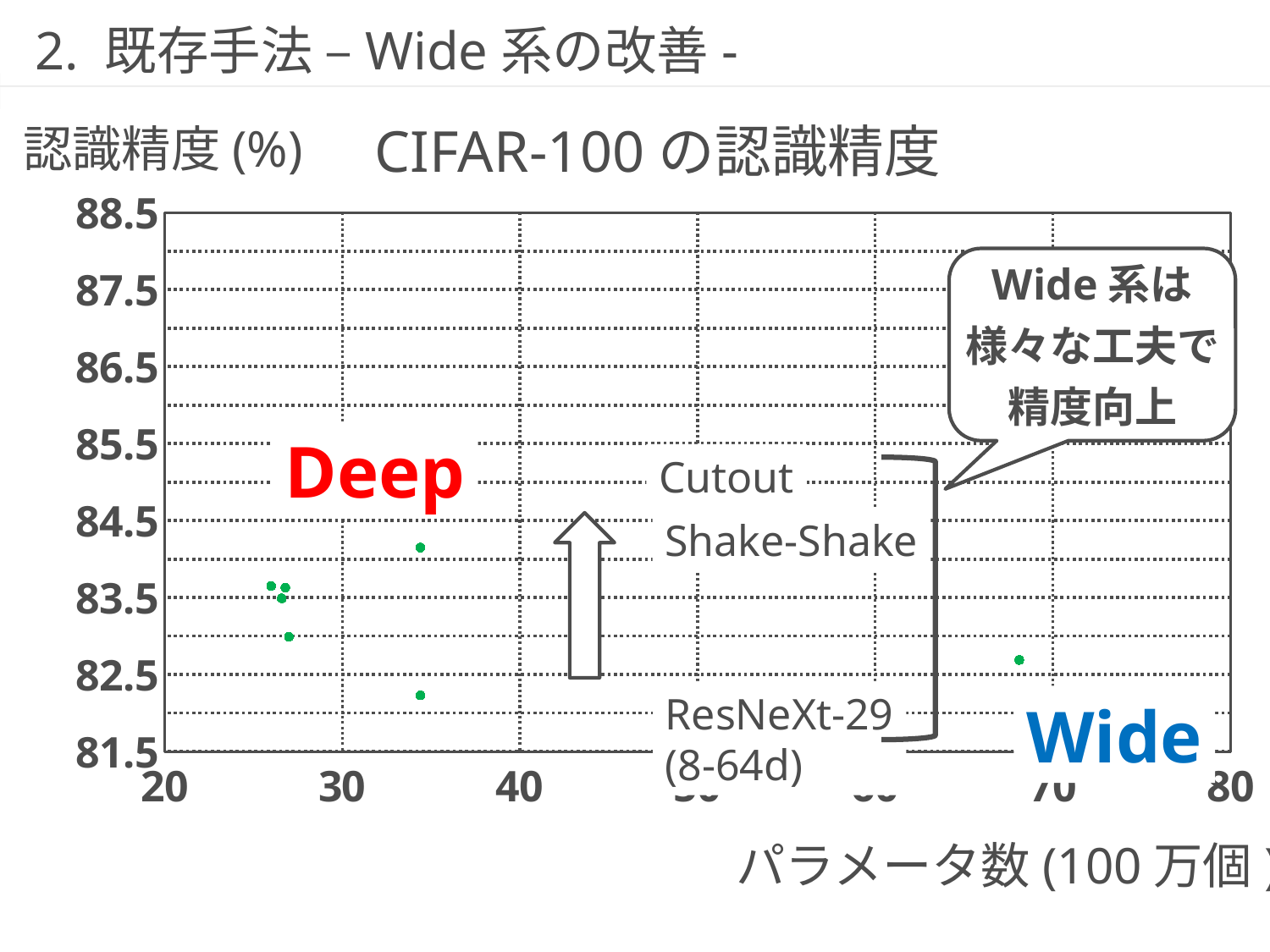
What kind of chart is shown on the slide? scatter chart Which is larger: the value of the point near 68 on the x axis or the value of the highest point near 35 on the x axis? the point near 35 on the x axis Is the value of the highest plotted point greater or less than 83.5? greater Which is larger: the value of the point near 68 on the x axis or the value of the lowest point near 35 on the x axis? the point near 68 on the x axis What is the title of the chart? CIFAR-100 の認識精度 Is the value of the lowest plotted point greater or less than 82.5? less Is the value of the point plotted near 68 on the x axis (the Wide point) greater or less than 82.5? greater What is the highest value shown on the y axis of the chart? 88.5 What is the lowest value shown on the x axis of the chart? 20 What is the label of the y axis of the chart? 認識精度 (%)